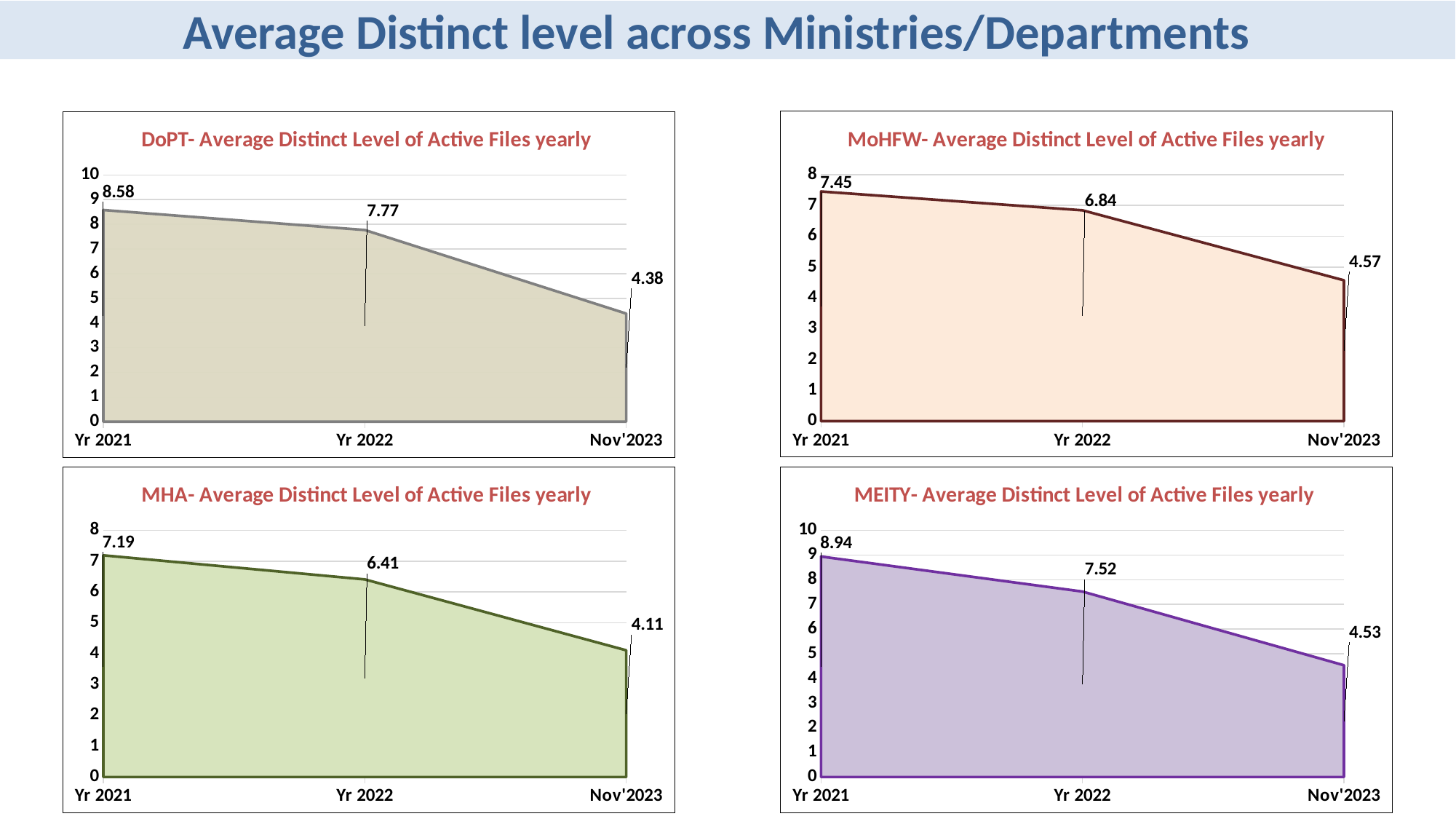
In the MHA chart, what is the value for Yr 2022? 6.41 In the MoHFW chart, what is the value for Nov'2023? 4.57 In the DoPT chart, what is the average distinct level of active files for Yr 2021? 8.58 What kind of chart is the MoHFW chart? Area chart In the MHA chart, which period has the highest value? Yr 2021 In the MEITY chart, which period has the lowest value? Nov'2023 In the MHA chart, how many time periods are plotted? 3 In the MEITY chart, what is the value for Yr 2021? 8.94 In the MEITY chart, do the values rise or fall from Yr 2021 to Nov'2023? Fall In the MoHFW chart, what is the difference between the Yr 2022 value and the Nov'2023 value? 2.27 In the DoPT chart, what is the difference between the Yr 2021 value and the Nov'2023 value? 4.20 Which is larger: the Yr 2022 value in the DoPT chart or the Yr 2022 value in the MEITY chart? DoPT